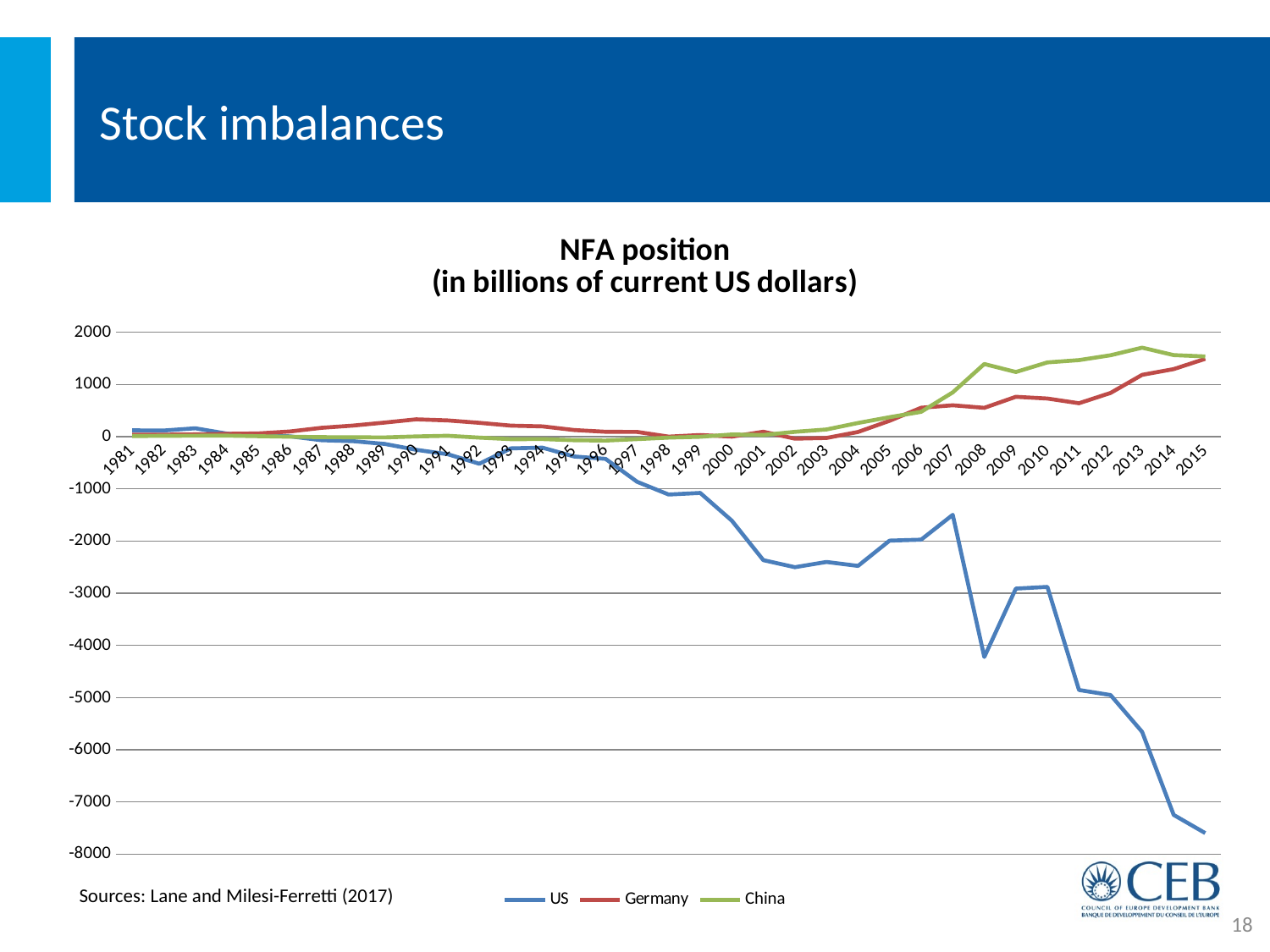
Is the value for the US in 2015 greater or less than -7000? less How many years are plotted along the x axis? 35 Is the value for China in 2013 greater or less than 1000? greater Which series has the lowest value in 2015? US Is the value for the US in 2007 greater or less than -2000? greater Does the US line rise or fall overall from 1981 to 2015? fall What is the title of the chart? NFA position (in billions of current US dollars) What kind of chart is shown on the slide? line chart How many series does the legend list? 3 Which series are listed in the legend? US, Germany, China In 2008, which series has the higher value, China or Germany? China